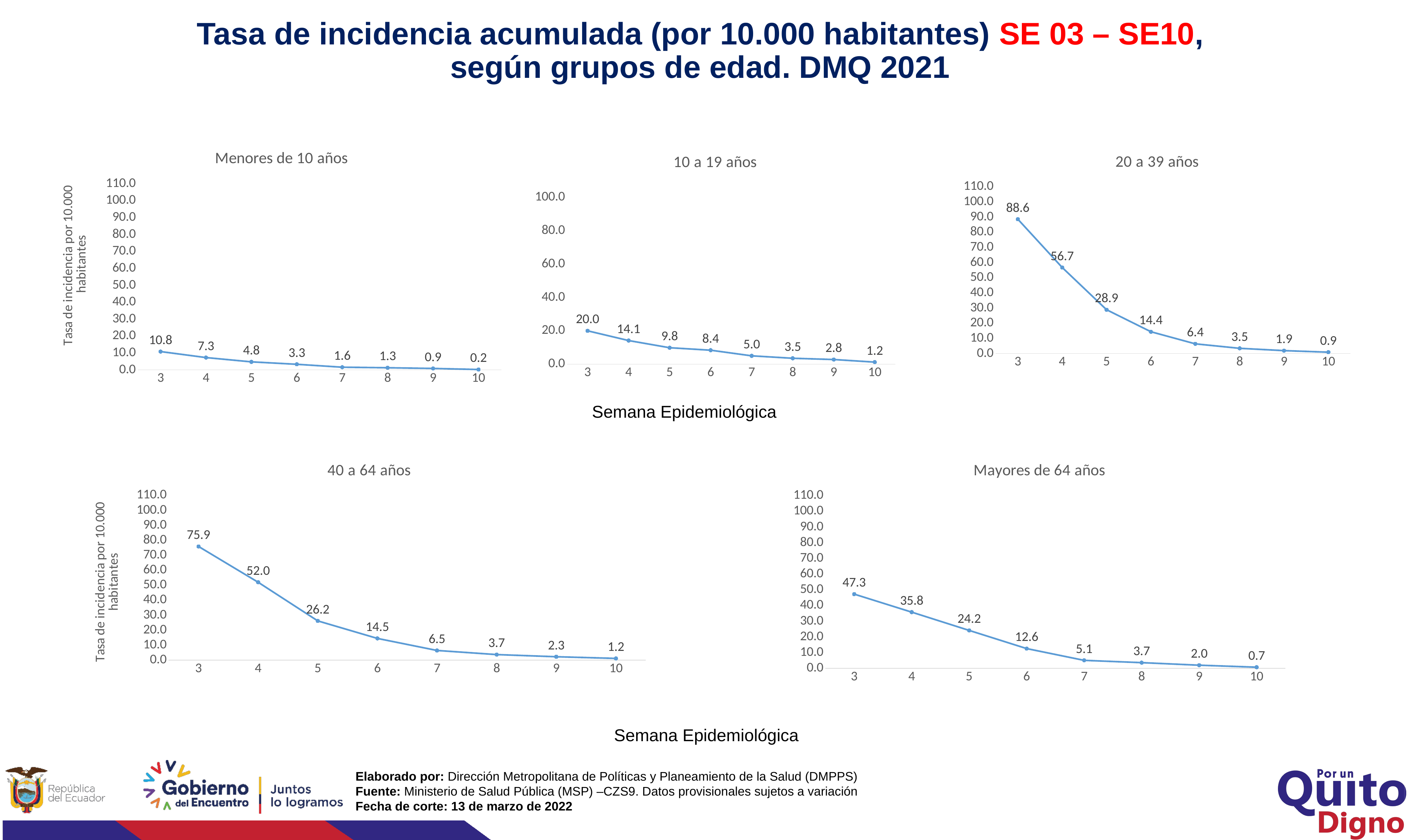
In the '40 a 64 años' chart, what is the value at week 6? 14.5 How many data points are plotted in the 'Menores de 10 años' chart? 8 In the '40 a 64 años' chart, which week has the lowest value? 10 In the 'Menores de 10 años' chart, what is the value at week 3? 10.8 In the '20 a 39 años' chart, what is the value at week 4? 56.7 In the '10 a 19 años' chart, what is the value at week 5? 9.8 In the 'Mayores de 64 años' chart, what is the difference between the values at week 3 and week 4? 11.5 In the '20 a 39 años' chart, do the values rise or fall from week 3 to week 10? fall In the '10 a 19 años' chart, which is larger: the value at week 4 or the value at week 6? week 4 In the '20 a 39 años' chart, which week has the highest value? 3 In the 'Mayores de 64 años' chart, what is the value at week 10? 0.7 What type of chart is the '40 a 64 años' chart? line chart